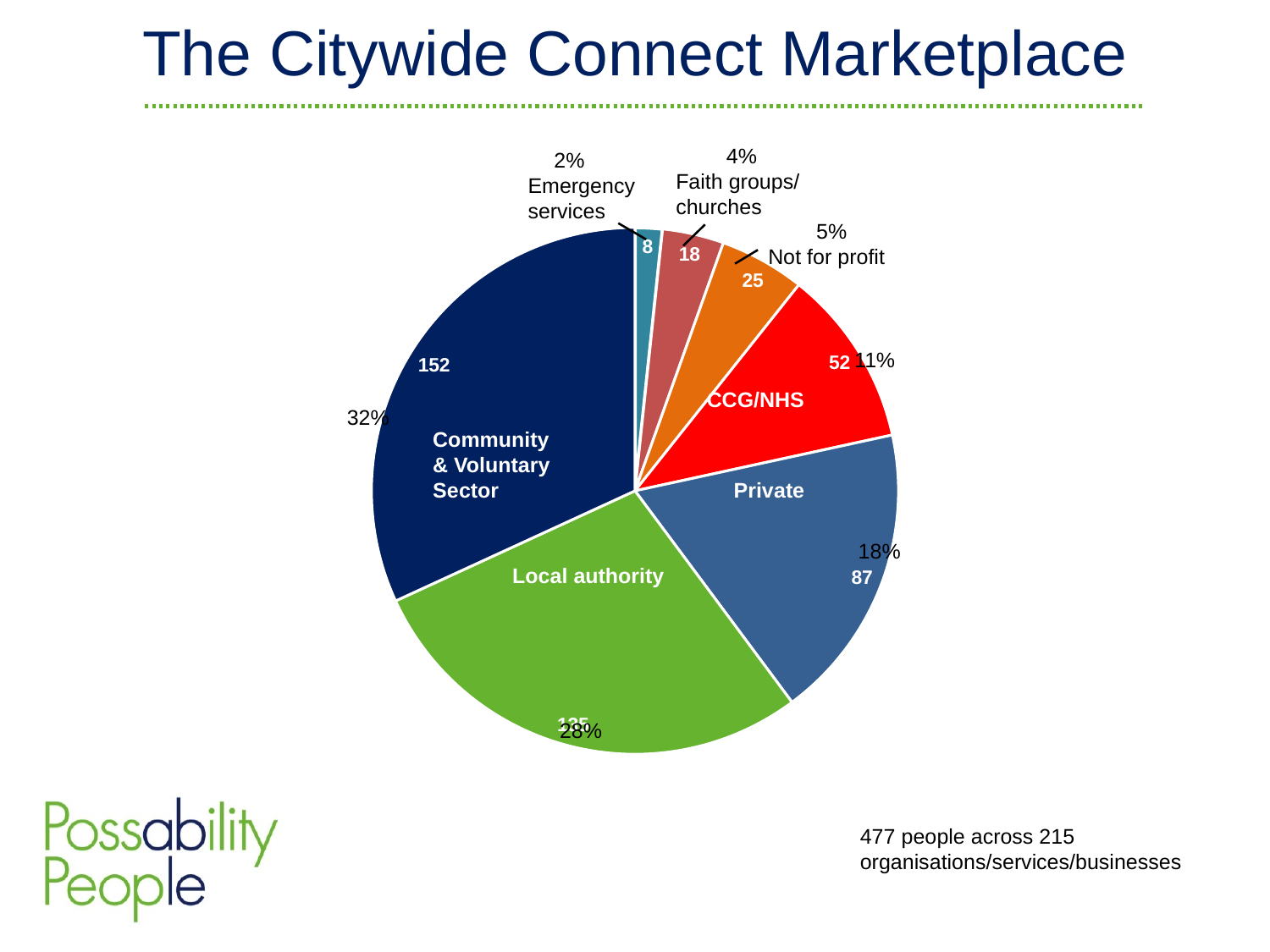
What is the difference between the values for Private and CCG/NHS? 35 What is the value shown for the Community & Voluntary Sector slice? 152 Which category has the largest slice of the pie? Community & Voluntary Sector What percentage share does the Local authority slice have? 28% What is the value shown for the CCG/NHS slice? 52 What kind of chart is shown on the slide? pie chart What is the value shown for the Private slice? 87 Which category has the smallest slice of the pie? Emergency services How many slices does the pie chart have? 7 Which is larger, the Not for profit slice or the Faith groups/churches slice? Not for profit What percentage share does the Community & Voluntary Sector slice have? 32% What percentage share does the Emergency services slice have? 2%